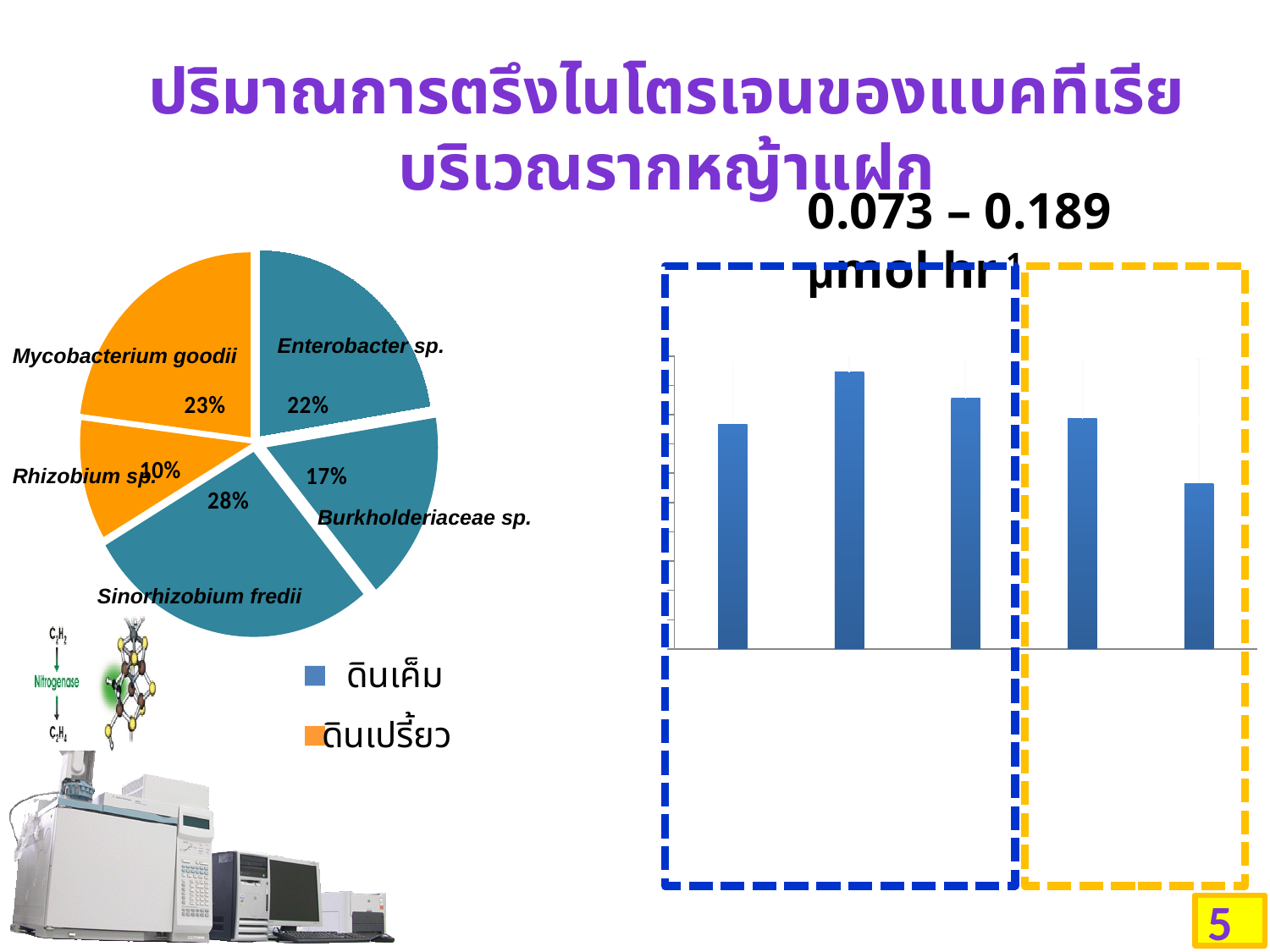
On the pie chart, which bacterium has the smallest slice? Rhizobium sp. How many entries does the legend of the pie chart list? 2 On the pie chart, which slice is larger: Mycobacterium goodii or Burkholderiaceae sp.? Mycobacterium goodii What kind of chart is the chart on the right side of the slide? bar chart How many slices does the pie chart have? 5 How many bars are plotted in the bar chart on the right side of the slide? 5 On the pie chart, what percentage is shown for Burkholderiaceae sp.? 17% On the pie chart, which bacterium has the largest slice? Sinorhizobium fredii On the pie chart, what is the difference in percentage points between Sinorhizobium fredii and Rhizobium sp.? 18 On the pie chart, what percentage is shown for Sinorhizobium fredii? 28% On the pie chart, what is the combined share of the two orange slices (Mycobacterium goodii and Rhizobium sp.)? 33% On the pie chart, what percentage is shown for Enterobacter sp.? 22%